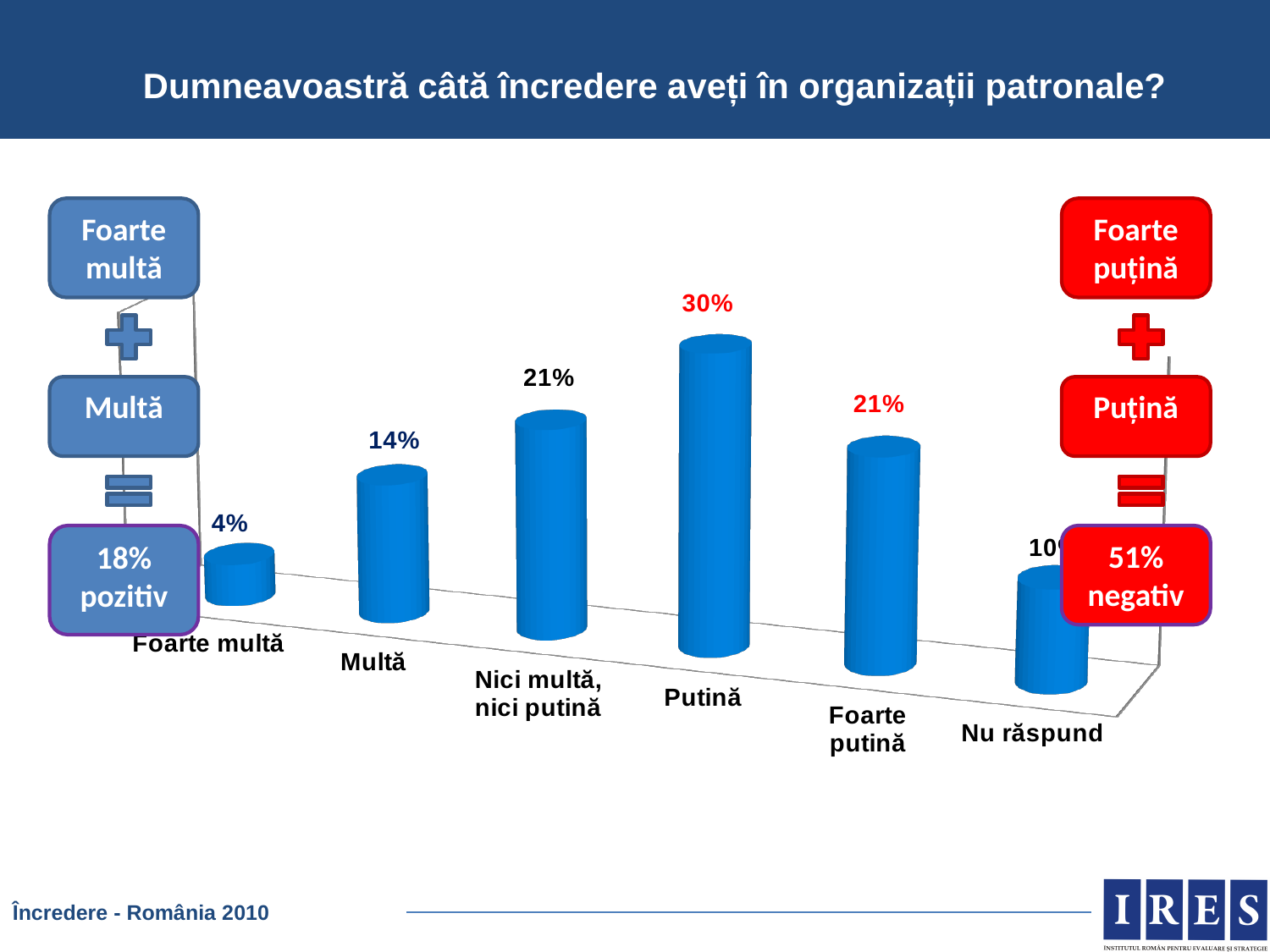
Which response category has the lowest percentage? Foarte multă What percentage of respondents answered "Putină" (little trust) in employers' organisations? 30% Which response category has the highest percentage? Putină What is the value shown for the "Foarte multă" category? 4% How many response categories are shown on the chart? 6 What kind of chart is shown on the slide? Bar chart What percentage is shown for the "Multă" category? 14% Which is larger, the value for "Multă" or the value for "Foarte multă"? Multă According to the summary boxes, what is the combined negative share ("negativ")? 51% What is the difference between the "Putină" value and the "Foarte multă" value? 26 percentage points What percentage of respondents answered "Foarte putină"? 21% What value is shown for "Nici multă, nici putină"? 21%